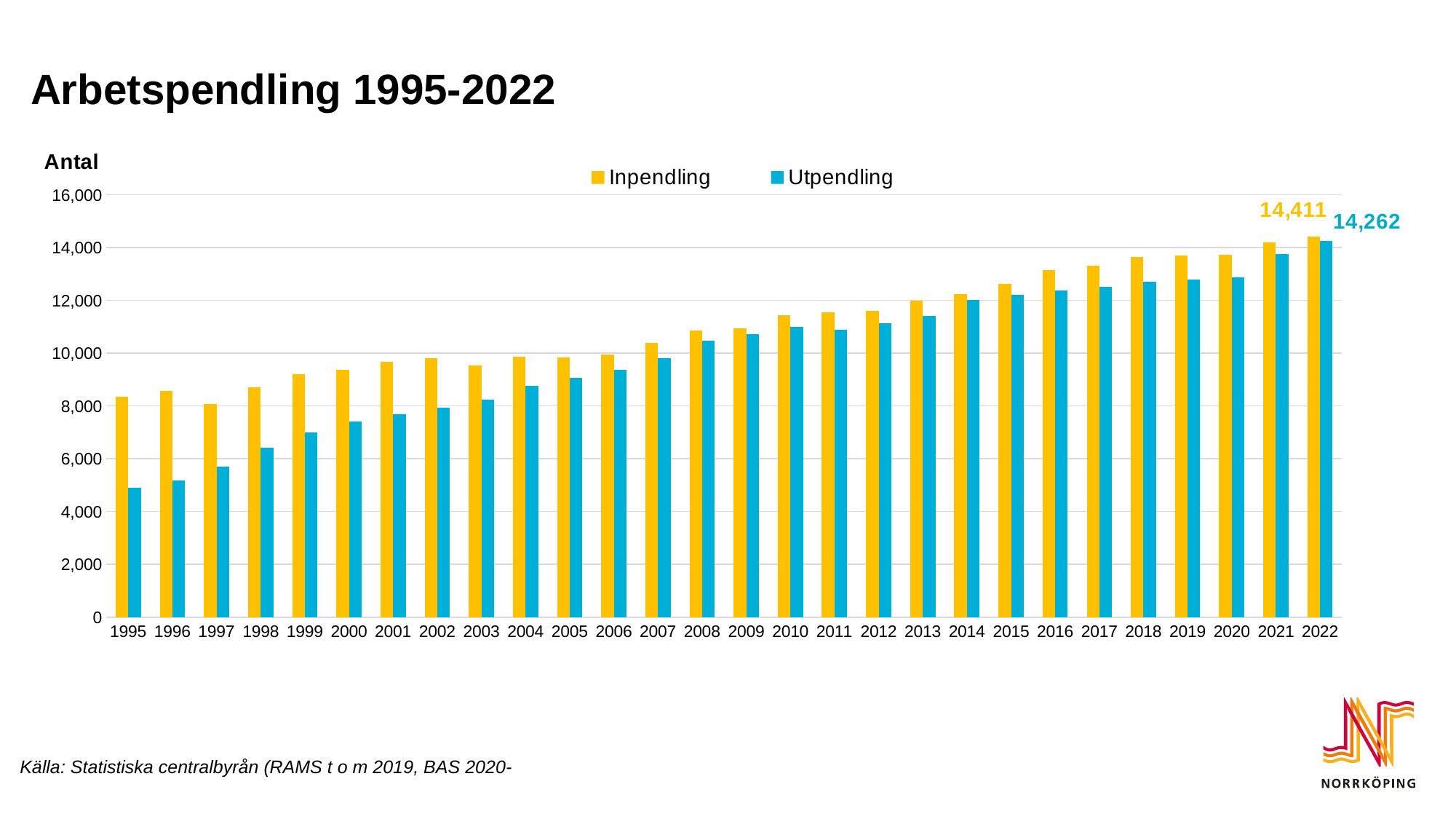
What is the value for Inpendling in 2022? 14,411 How many years are shown on the x axis? 28 Is the value for Inpendling in 1995 greater or less than 8,000? greater In which year is Utpendling lowest? 1995 Is the value for Utpendling in 1995 greater or less than 6,000? less What is the difference between Inpendling and Utpendling in 2022? 149 Which is larger in 1995, Inpendling or Utpendling? Inpendling What kind of chart is shown on the slide? Bar chart Does Utpendling generally rise or fall from 1995 to 2022? Rise How many series does the legend list? 2 What is the value for Utpendling in 2022? 14,262 Which is larger in 2022, Inpendling or Utpendling? Inpendling